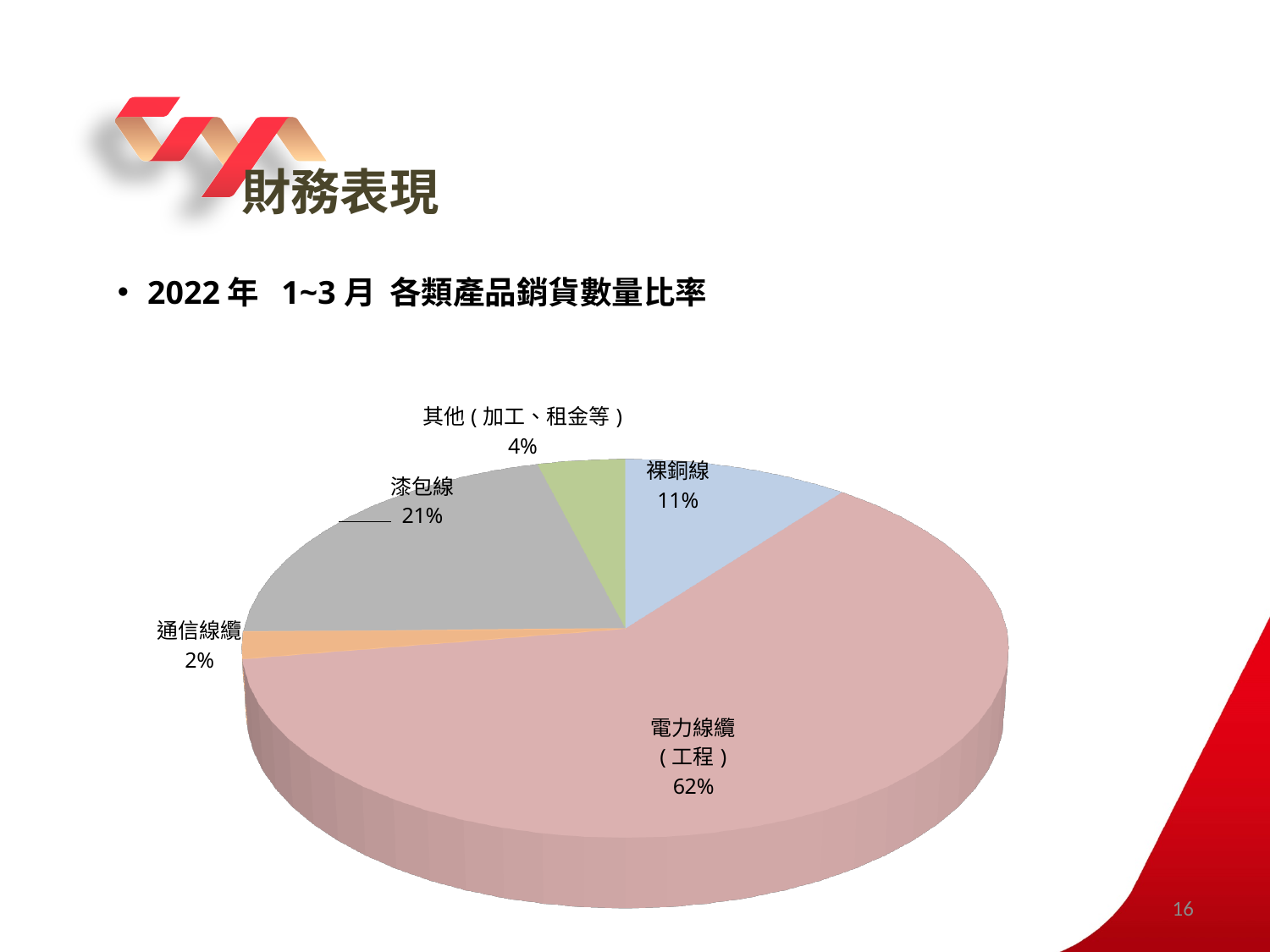
What kind of chart is shown on the slide? pie chart What is the value shown for 漆包線? 21% What period does the chart title say the sales quantity ratios cover? 2022年 1~3月 What is the value shown for 裸銅線? 11% Which is larger, the share for 裸銅線 or the share for 其他（加工、租金等）? 裸銅線 What is the difference in percentage points between 漆包線 and 裸銅線? 10 How many categories are shown in the pie chart? 5 Which category has the largest slice of the pie? 電力線纜（工程） What is the value shown for 其他（加工、租金等）? 4% What is the value shown for 通信線纜? 2% What share of the pie does 電力線纜（工程） account for? 62% Which category has the smallest slice of the pie? 通信線纜